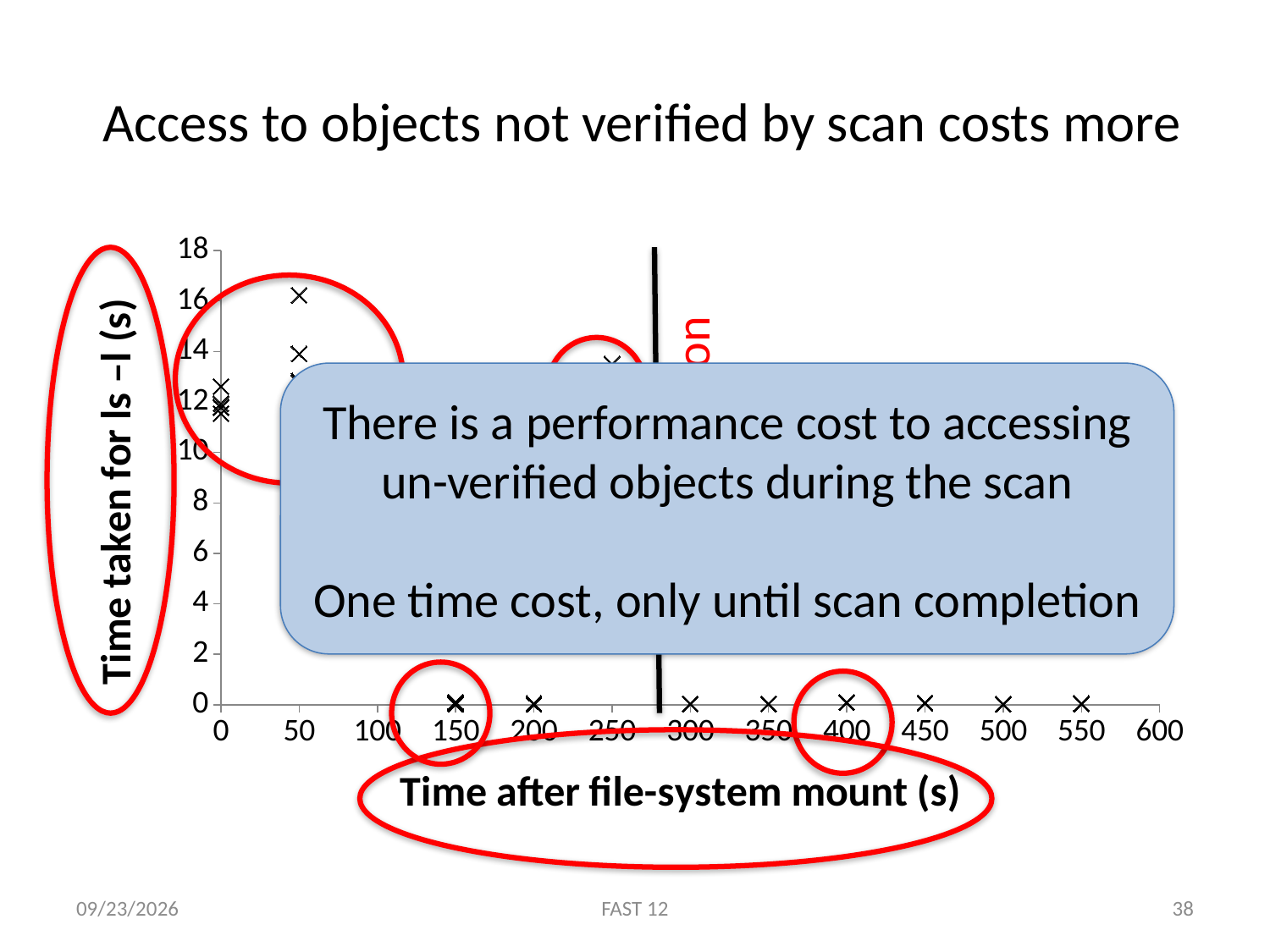
Overall, do the plotted ls –l times rise or fall as time after file-system mount increases? fall What is the label of the y axis of the chart? Time taken for ls –l (s) Are the values plotted at 0 s after mount greater or less than 14? less Is the value plotted at 150 s after mount greater or less than 4? less Which is larger: the highest value plotted at 50 s after mount or the value plotted at 500 s after mount? 50 s after mount Is the value plotted at 550 s after mount greater or less than 2? less What is the maximum value shown on the y axis of the chart? 18 What is the label of the x axis of the chart? Time after file-system mount (s) What kind of chart is shown on the slide? scatter chart